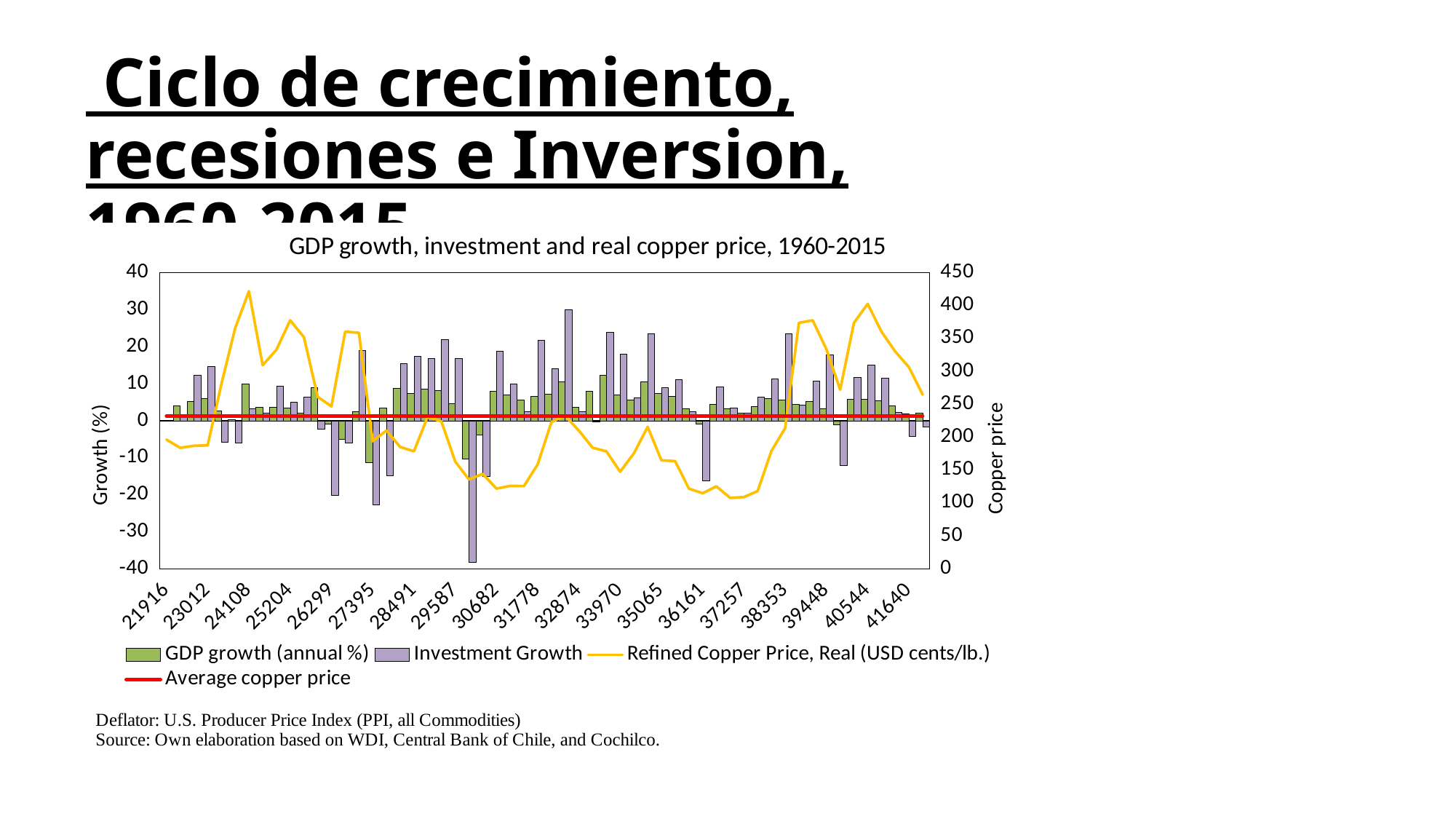
Which series contains the lowest bar on the chart? Investment Growth Which series is plotted with the yellow line? Refined Copper Price, Real (USD cents/lb.) Is the lowest Investment Growth bar greater or less than -30 on the Growth (%) axis? less How many series does the chart legend list? 4 Does the Refined Copper Price line rise or fall between the x-axis labels 37257 and 38353? rise Is the highest point of the Refined Copper Price line greater or less than 350 on the Copper price axis? greater How many tick labels are shown on the x axis? 19 What kind of chart is this? Combination bar and line chart Is the highest Investment Growth bar greater or less than 20 on the Growth (%) axis? greater What is the title of the chart? GDP growth, investment and real copper price, 1960-2015